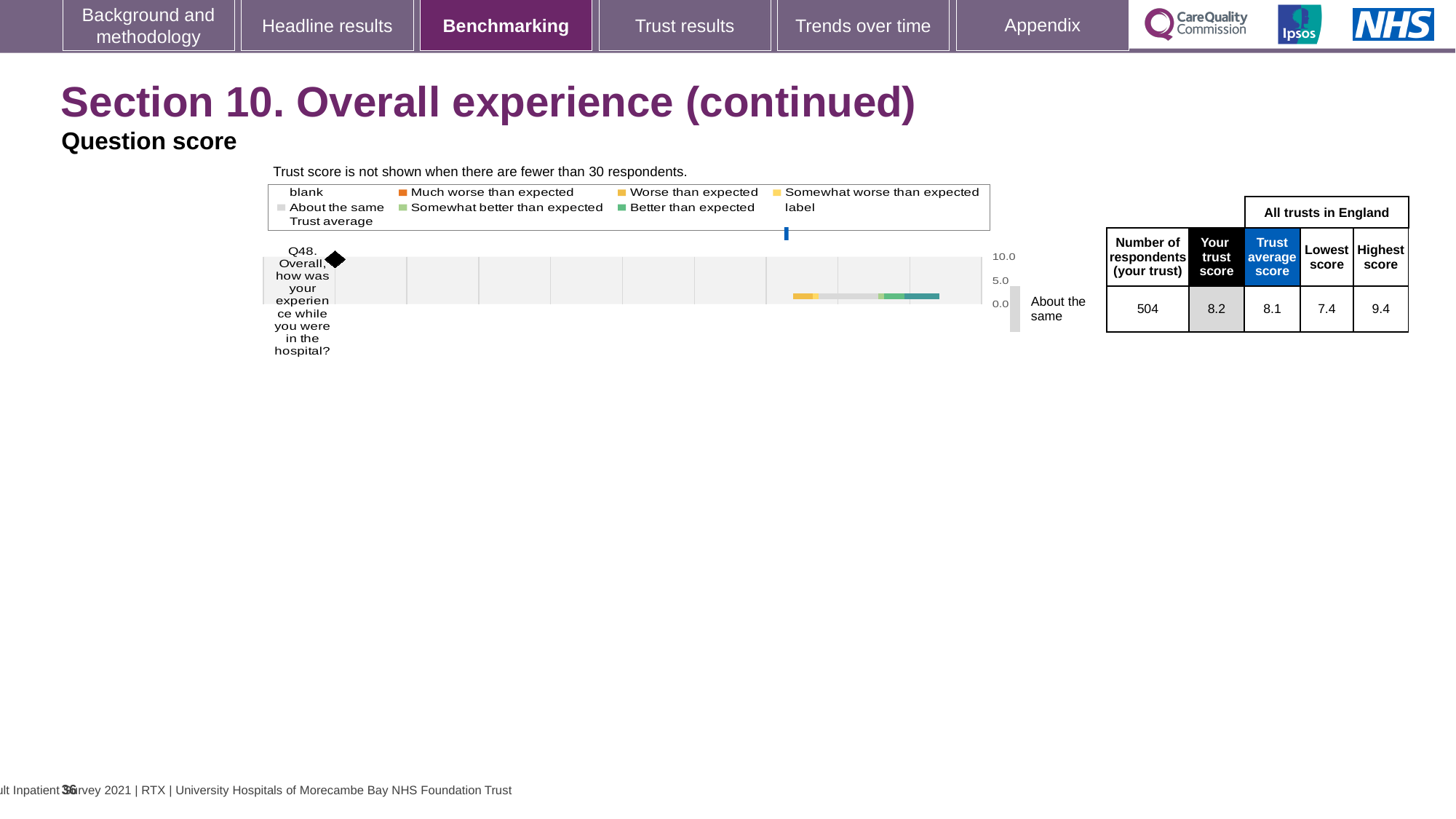
What is the difference between the highest score and the lowest score for Q48? 2.0 How many respondents from the trust answered Q48? 504 What is the trust average score for Q48 across all trusts in England? 8.1 Is the trust score for Q48 greater or less than 5.0? greater Which benchmarking category is the trust's Q48 score placed in? About the same What kind of chart is used to show the Q48 benchmarking result? Bar chart What is the lowest score for Q48 among all trusts in England? 7.4 What is the difference between the trust's score and the trust average score for Q48? 0.1 What is the highest score for Q48 among all trusts in England? 9.4 How many questions are plotted on the benchmarking chart? 1 Which is larger for Q48: the trust's own score or the trust average score? The trust's own score (8.2) What is the trust score for Q48 (Overall, how was your experience while you were in the hospital?)? 8.2